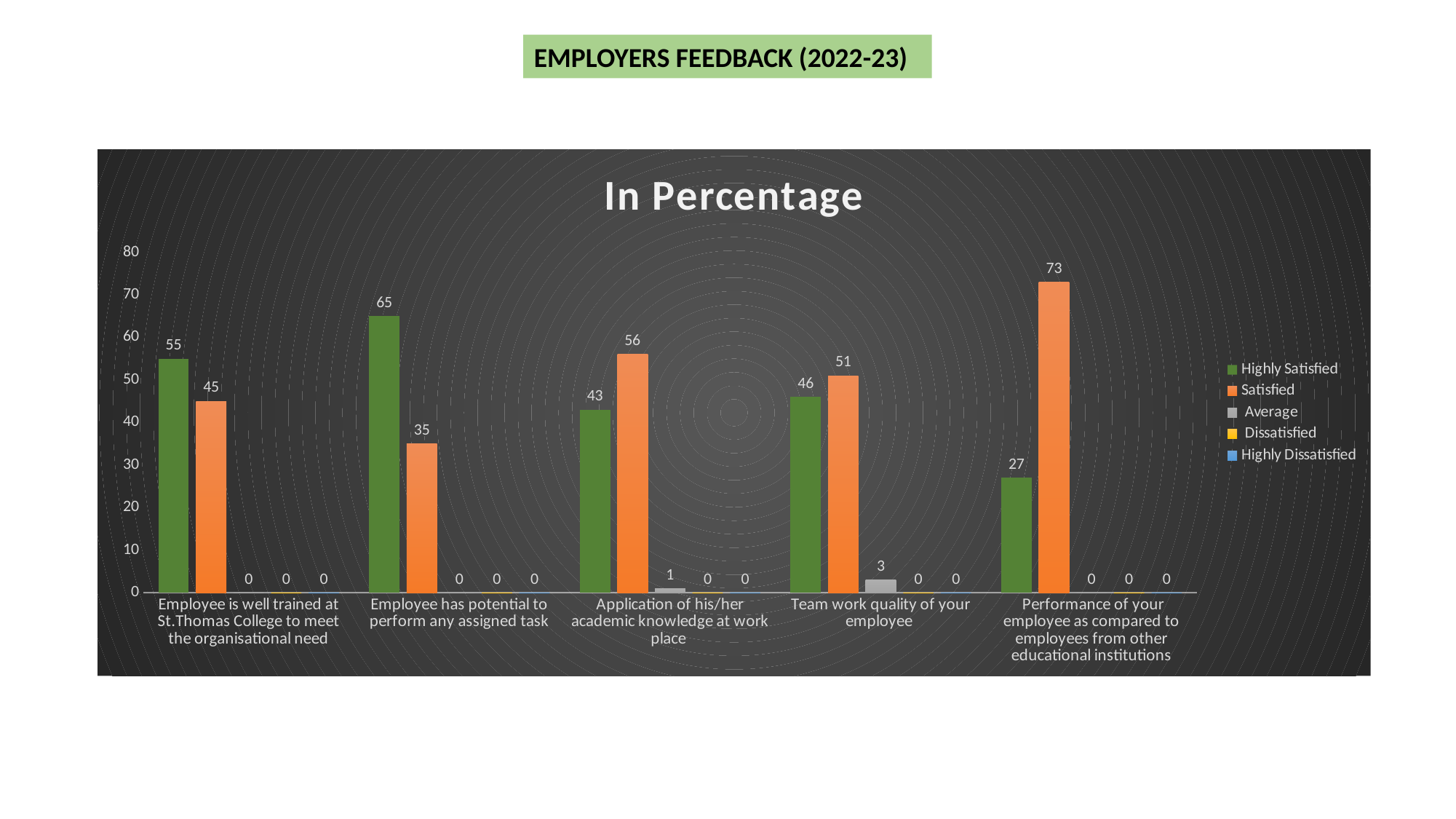
What is the Average value for "Team work quality of your employee"? 3 What is the Dissatisfied value for "Team work quality of your employee"? 0 Which category has the highest Satisfied value? Performance of your employee as compared to employees from other educational institutions Which category has the lowest Highly Satisfied value? Performance of your employee as compared to employees from other educational institutions What is the Satisfied value for "Performance of your employee as compared to employees from other educational institutions"? 73 What is the Highly Satisfied value for "Employee has potential to perform any assigned task"? 65 For "Application of his/her academic knowledge at work place", which is larger: Highly Satisfied or Satisfied? Satisfied How many series does the legend list? 5 What kind of chart is shown on the slide? Bar chart What is the difference between the Highly Satisfied and Satisfied values for "Employee has potential to perform any assigned task"? 30 How many categories are shown on the x axis? 5 What is the title of the chart? In Percentage